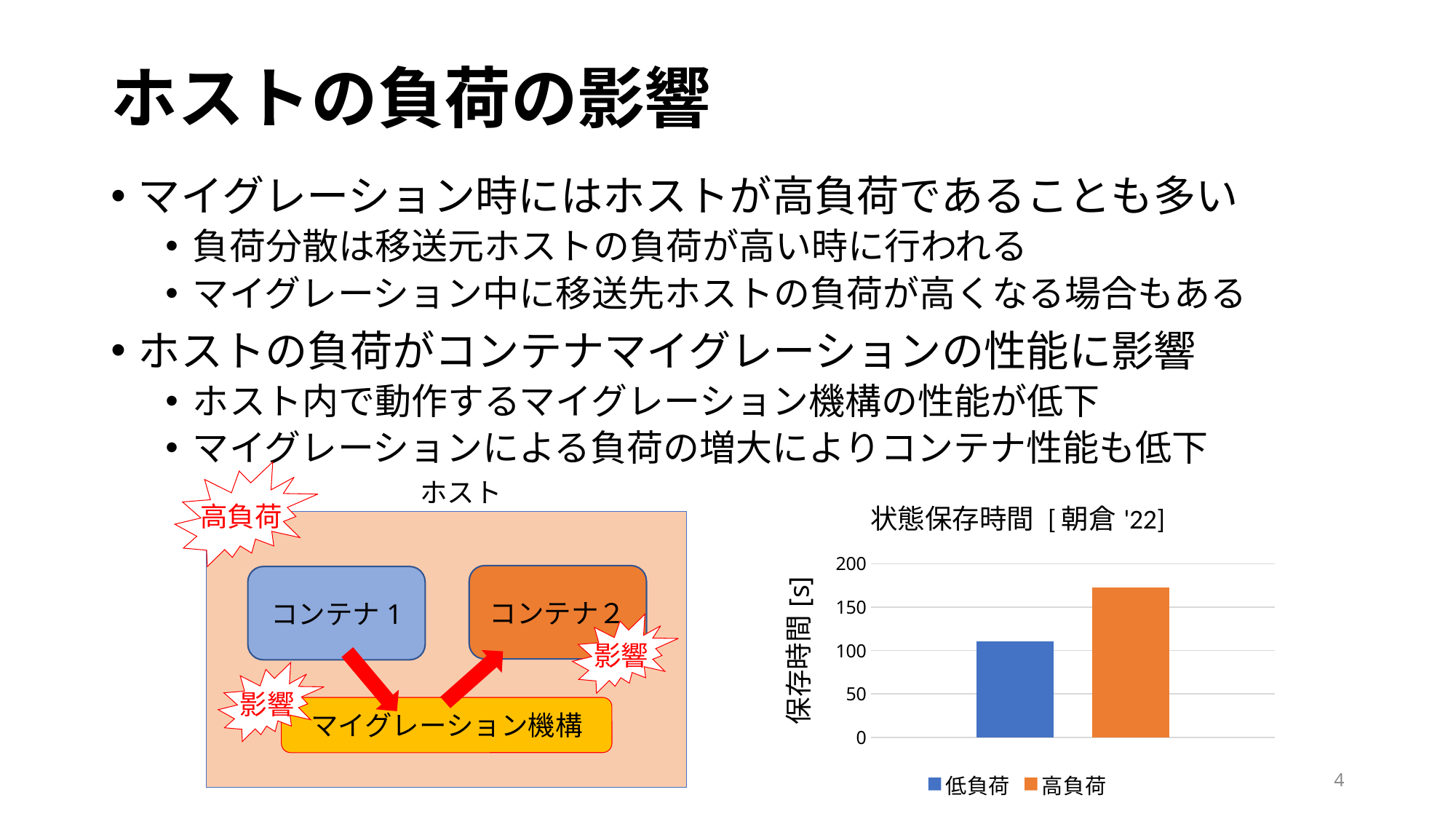
How many bars are plotted in the chart? 2 How many series does the legend of the chart list? 2 Which series has the highest value in the chart? 高負荷 What kind of chart is shown on the slide? bar chart Is the value for 低負荷 greater or less than 100? greater What is the title of the chart? 状態保存時間 [朝倉 '22] Is the value for 高負荷 greater or less than 150? greater Which series has the lowest value in the chart? 低負荷 Is the value for 低負荷 greater or less than 150? less What is the label of the vertical axis of the chart? 保存時間 [s] Which is larger in the chart, the value for 低負荷 or the value for 高負荷? 高負荷